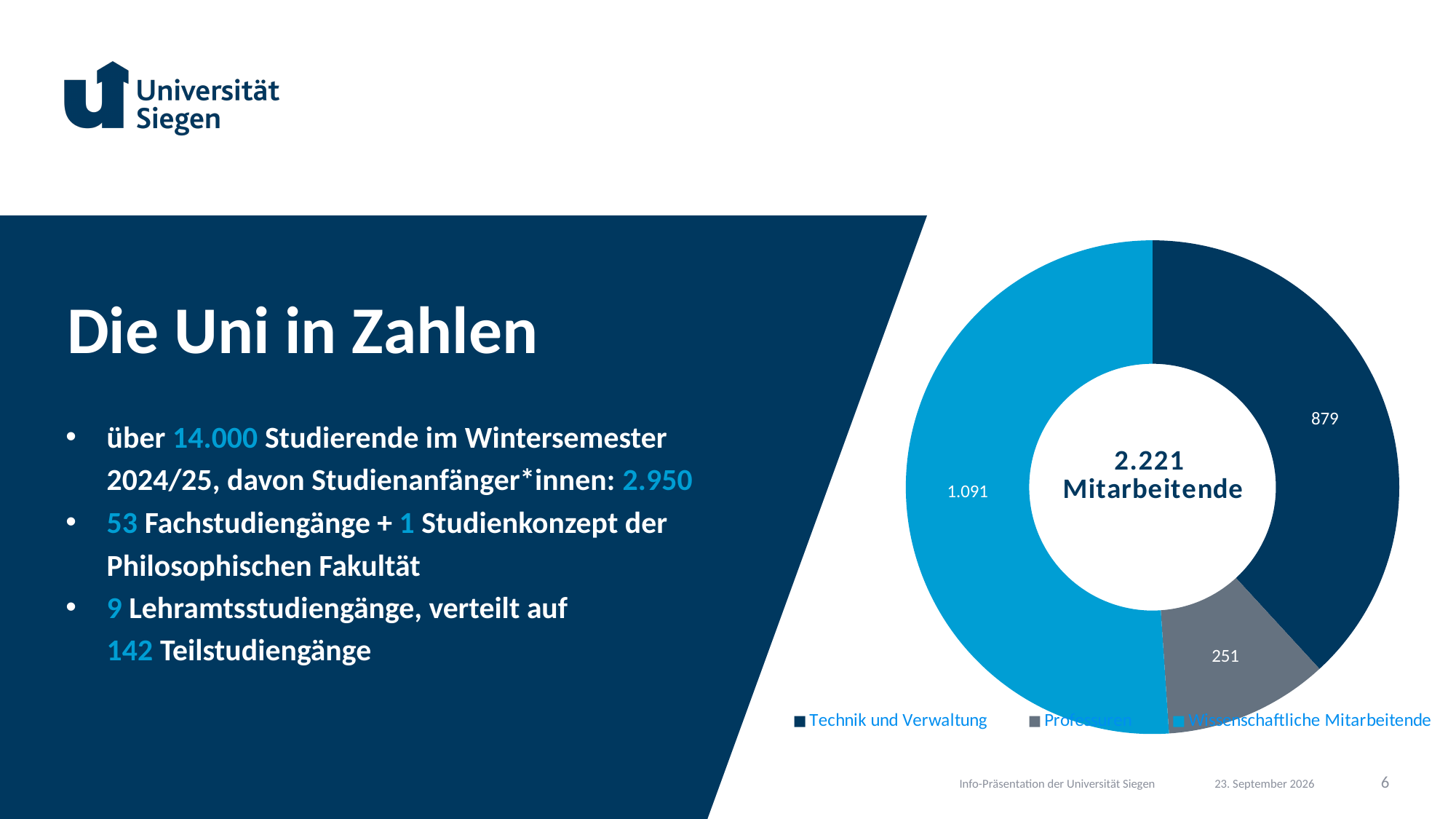
What kind of chart is shown on the slide? Doughnut (pie) chart What is the value for Technik und Verwaltung in the chart? 879 How many segments does the chart have? 3 Which category has the smallest segment in the chart? Professuren Which category has the largest segment in the chart? Wissenschaftliche Mitarbeitende What total number of Mitarbeitende is shown in the centre of the chart? 2.221 Mitarbeitende What is the value for Wissenschaftliche Mitarbeitende in the chart? 1.091 What colour is the Technik und Verwaltung segment in the chart? Dark blue What is the difference between Wissenschaftliche Mitarbeitende and Technik und Verwaltung? 212 Which is larger, Technik und Verwaltung or Wissenschaftliche Mitarbeitende? Wissenschaftliche Mitarbeitende What is the value shown on the grey segment of the chart? 251 What is the difference between Technik und Verwaltung and the grey segment (251)? 628